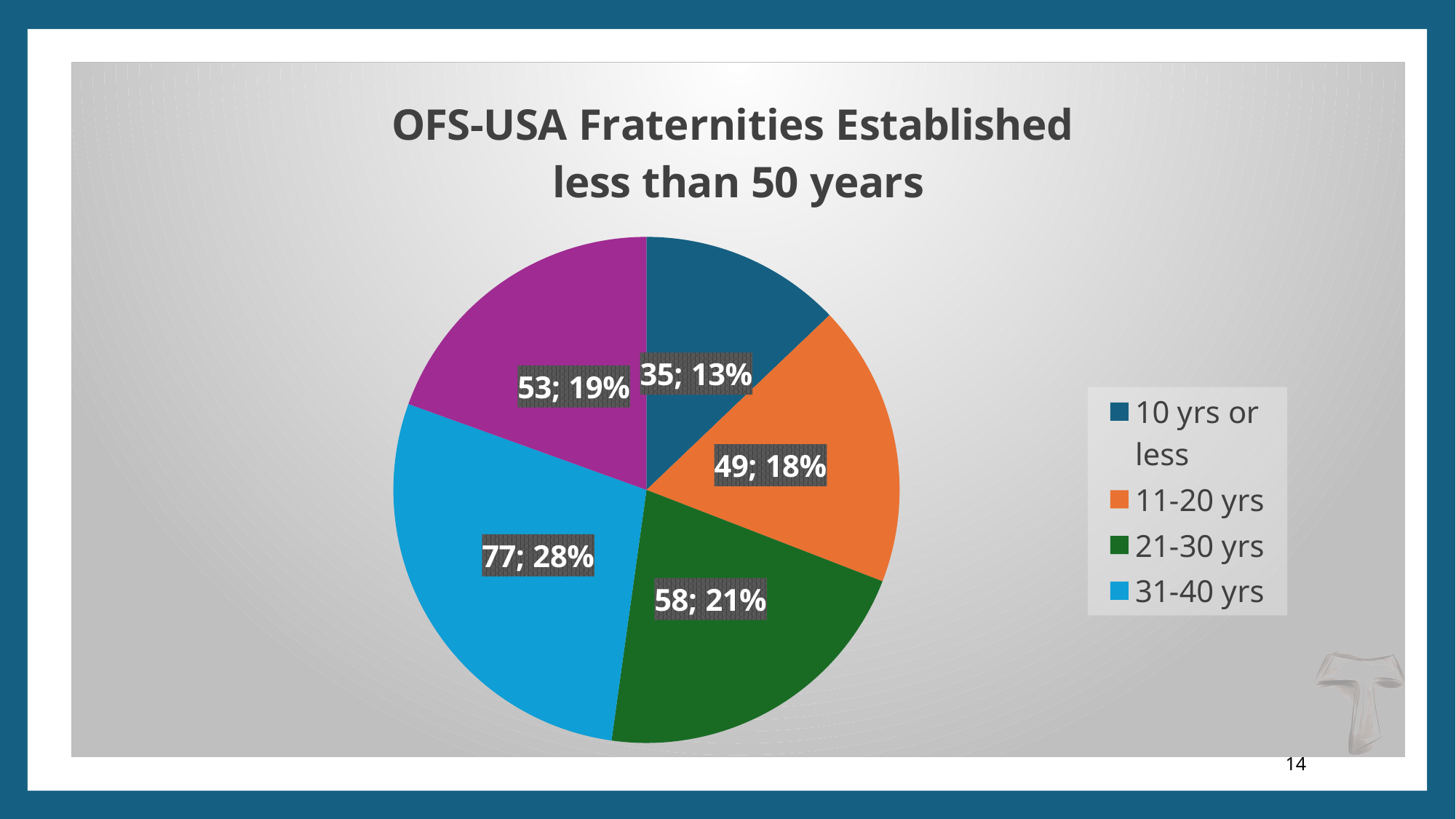
Which category has the largest slice of the pie? 31-40 yrs How many fraternities are in the '10 yrs or less' slice? 35 What share of the pie does the '10 yrs or less' slice represent? 13% What kind of chart is shown on the slide? pie chart Which is larger, the value for '21-30 yrs' or the value for '11-20 yrs'? 21-30 yrs What is the difference between the values for '31-40 yrs' and '10 yrs or less'? 42 What share of the pie does the '31-40 yrs' slice represent? 28% Which category has the smallest slice of the pie? 10 yrs or less What value is shown for the '31-40 yrs' slice? 77 What percentage is shown for the '21-30 yrs' slice? 21% What is the title of the chart? OFS-USA Fraternities Established less than 50 years What value is shown for the '11-20 yrs' slice? 49